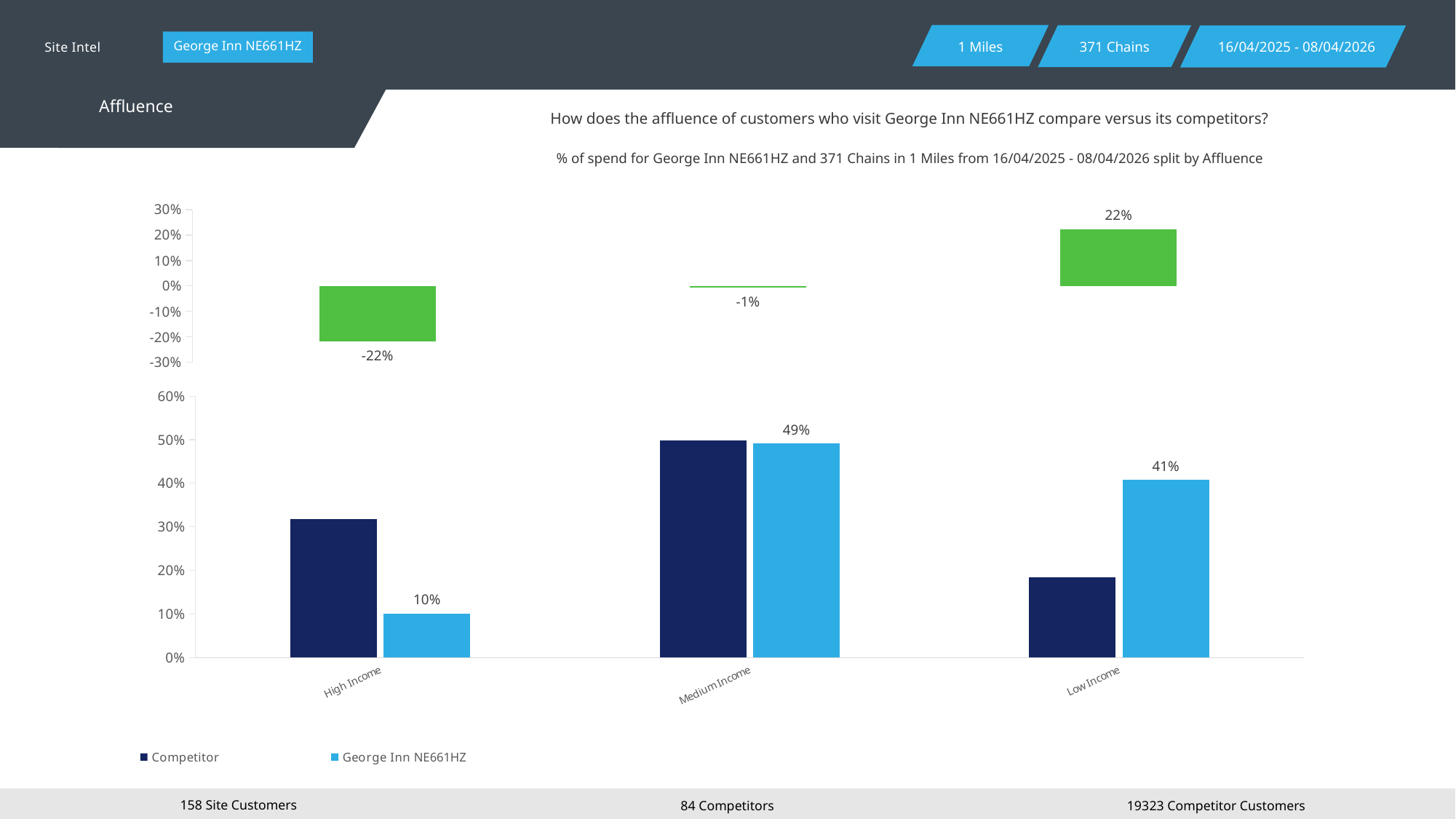
How many series does the legend of the bottom chart list? 2 In the bottom chart, what is the difference between the George Inn NE661HZ values for Medium Income and High Income? 39% In the bottom chart, what is the value for George Inn NE661HZ in the High Income category? 10% In the bottom chart, what is the value for George Inn NE661HZ in the Medium Income category? 49% In the top chart, what is the value shown for the High Income category? -22% In the top chart, what is the value shown for the Low Income category? 22% In the bottom chart, is the Competitor value for Low Income greater or less than 30%? less In the bottom chart, which category has the highest value for George Inn NE661HZ? Medium Income In the bottom chart, is the Competitor value for High Income greater or less than 20%? greater In the bottom chart, which is larger for Low Income: the Competitor value or the George Inn NE661HZ value? George Inn NE661HZ In the bottom chart, what is the value for George Inn NE661HZ in the Low Income category? 41% In the top chart, which category has the lowest value? High Income